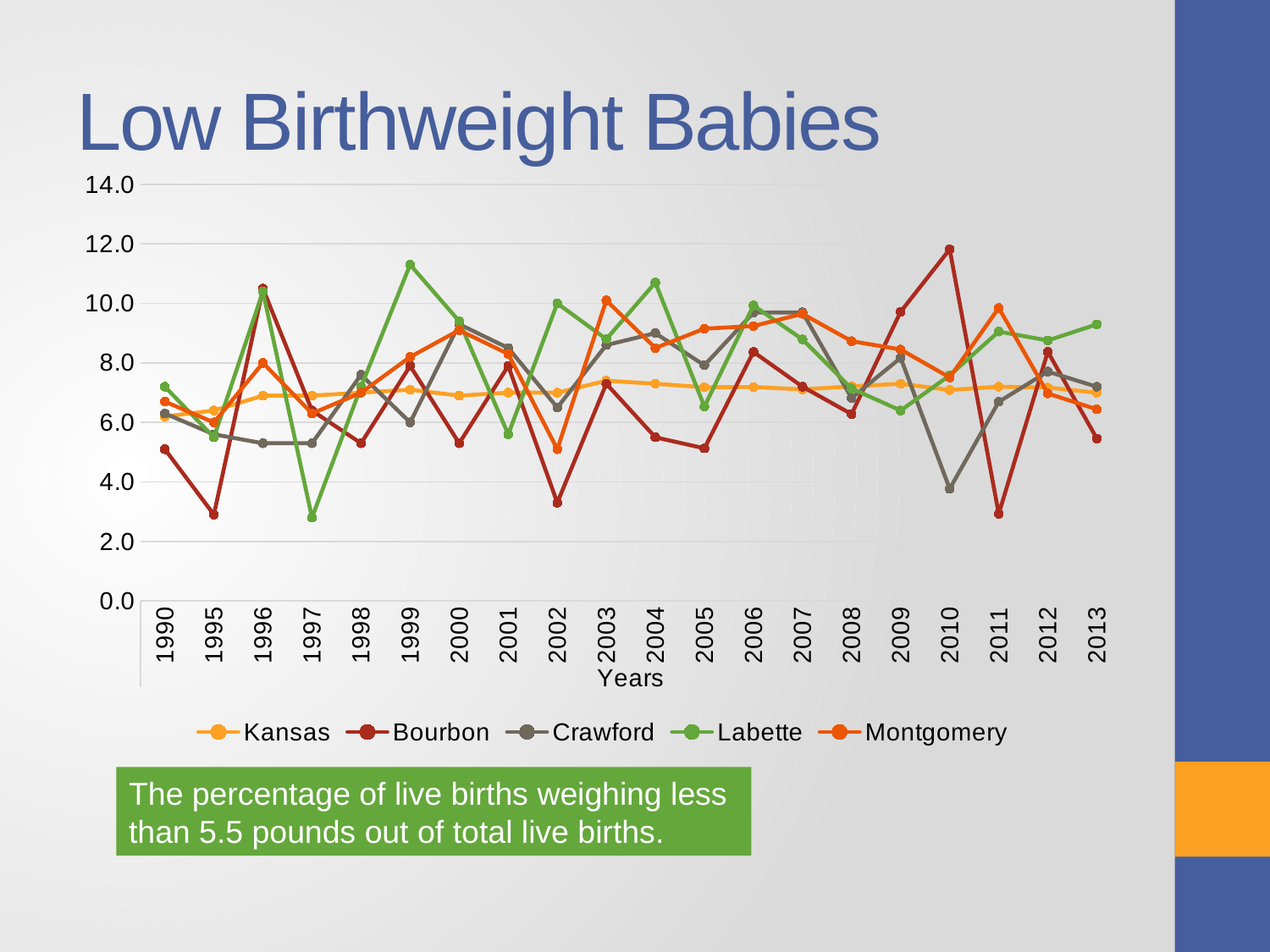
Is the value for Crawford in 2010 greater or less than 6.0? less What is the title of the x axis? Years How many series does the legend list? 5 In 2010, which is larger: the value for Bourbon or the value for Labette? Bourbon What kind of chart is shown on the slide? line chart In which year does the Bourbon series reach its highest value? 2010 Is the value for Kansas in 1990 greater or less than 8.0? less Is the value for Bourbon in 2010 greater or less than 10.0? greater How many years are plotted along the x axis? 20 In which year does the Labette series reach its lowest value? 1997 In which year does the Crawford series reach its lowest value? 2010